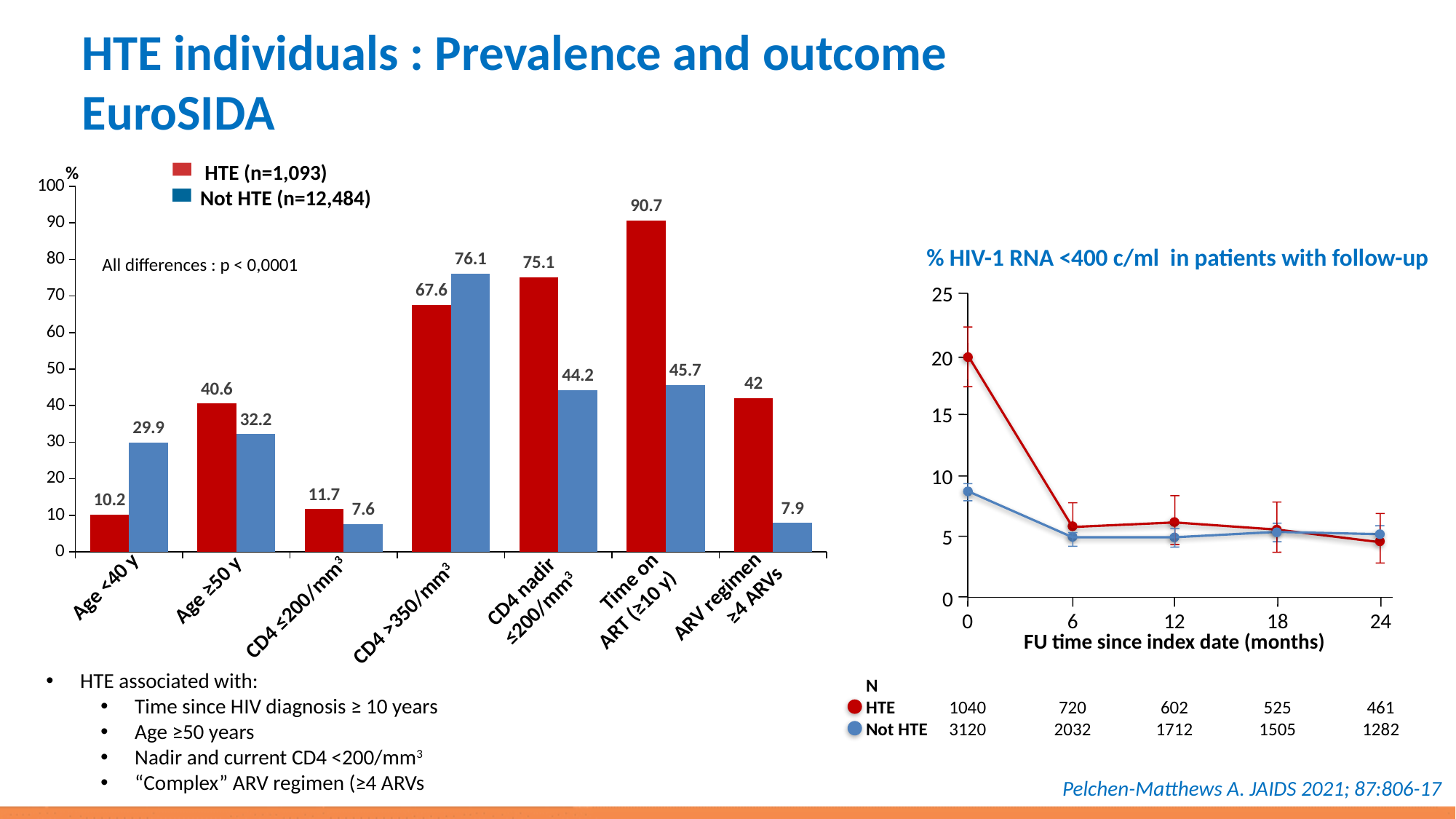
How many categories are shown on the x axis of the left bar chart? 7 In the left bar chart, which category has the lowest Not HTE value? CD4 ≤200/mm3 In the left bar chart, which is larger for Age <40 y: the HTE value or the Not HTE value? Not HTE In the right chart '% HIV-1 RNA <400 c/ml in patients with follow-up', is the HTE value at 0 months greater or less than 15? greater In the right chart '% HIV-1 RNA <400 c/ml in patients with follow-up', is the Not HTE value at 0 months greater or less than 10? less In the left bar chart, what is the HTE value for Time on ART (≥10 y)? 90.7 In the left bar chart, what is the difference between the HTE and Not HTE values for CD4 nadir ≤200/mm3? 30.9 In the left bar chart, which category has the highest HTE value? Time on ART (≥10 y) In the left bar chart, what is the Not HTE value for CD4 >350/mm3? 76.1 How many series does the legend of the left bar chart list? 2 In the left bar chart, what is the HTE value for ARV regimen ≥4 ARVs? 42 What kind of chart is the right chart '% HIV-1 RNA <400 c/ml in patients with follow-up'? line chart